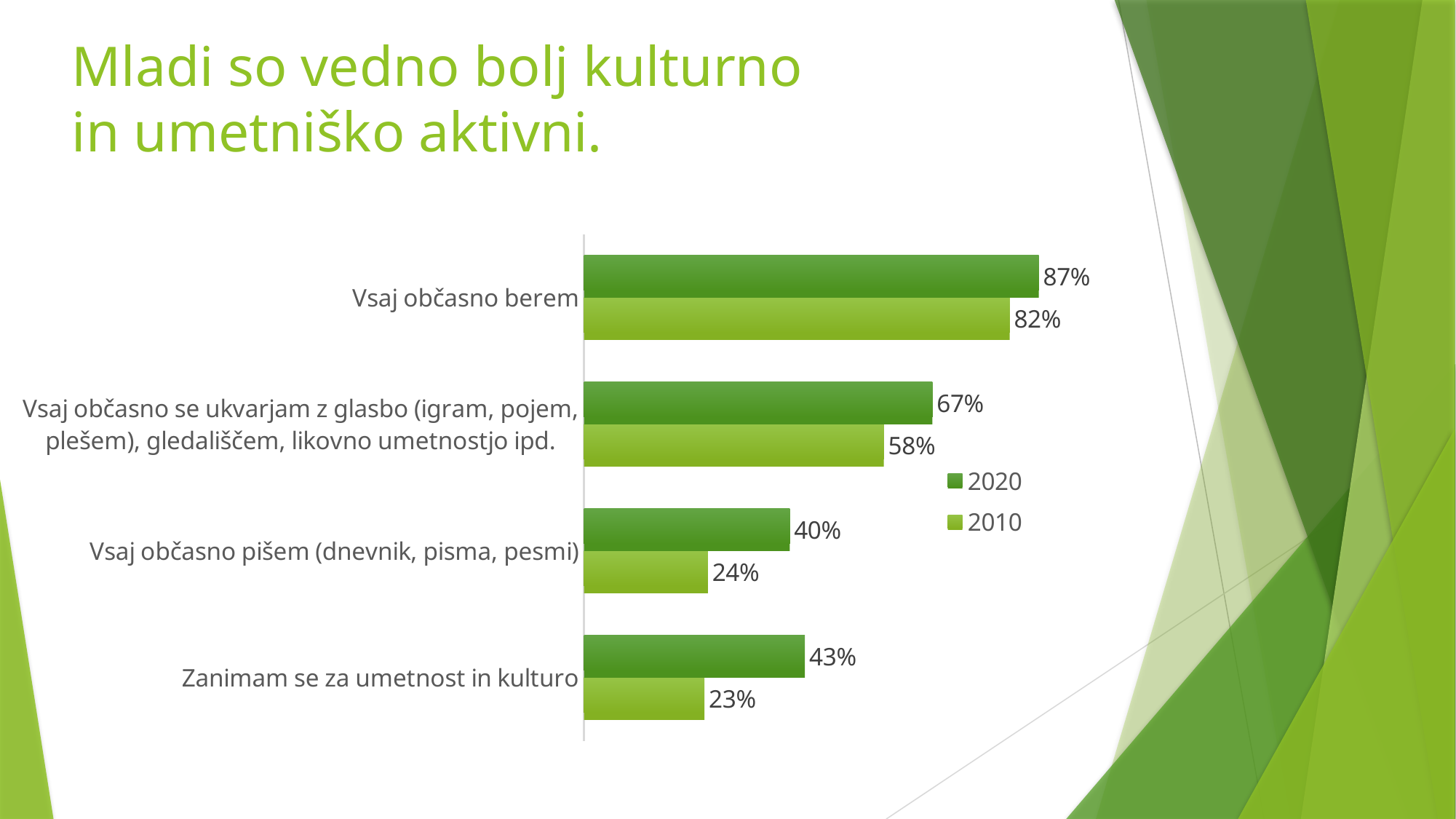
Which is larger: the 2020 value for "Vsaj občasno pišem (dnevnik, pisma, pesmi)" or the 2020 value for "Zanimam se za umetnost in kulturo"? Zanimam se za umetnost in kulturo What kind of chart is shown on the slide? Bar chart How many categories are shown in the chart? 4 How many series does the legend list? 2 What is the difference between the 2020 and 2010 values for "Vsaj občasno se ukvarjam z glasbo (igram, pojem, plešem), gledališčem, likovno umetnostjo ipd."? 9% What is the 2010 value for "Vsaj občasno pišem (dnevnik, pisma, pesmi)"? 24% Which series is shown in the darker green colour? 2020 What is the difference between the 2020 and 2010 values for "Zanimam se za umetnost in kulturo"? 20% What is the 2010 value for "Zanimam se za umetnost in kulturo"? 23% What is the 2020 value for "Vsaj občasno berem"? 87% Which category has the highest 2020 value? Vsaj občasno berem Which category has the lowest 2010 value? Zanimam se za umetnost in kulturo